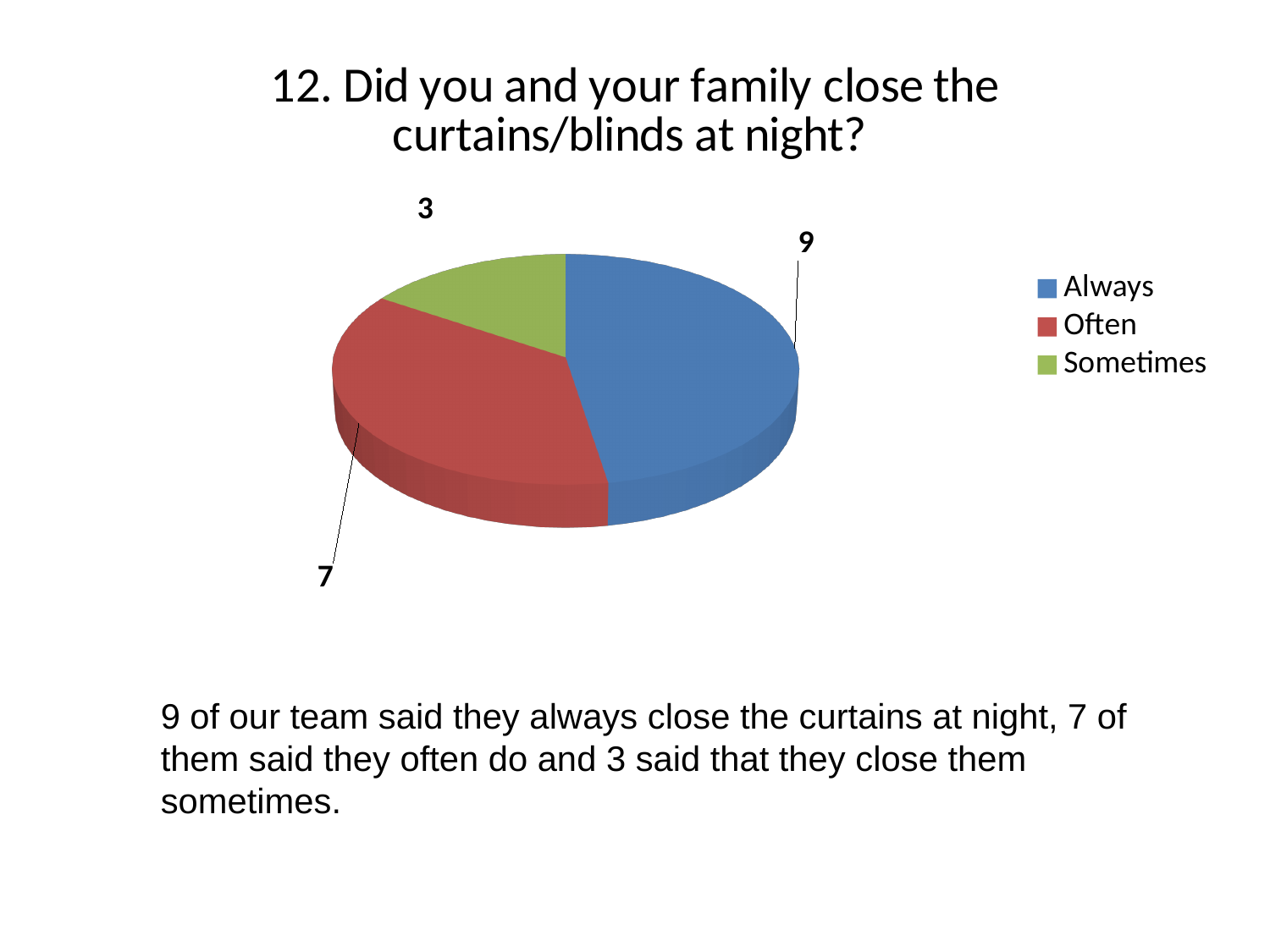
How many people answered "Always"? 9 How many people answered "Often"? 7 Which response has the largest slice of the pie? Always How many categories does the pie chart have? 3 What kind of chart is shown on the slide? pie chart What is the difference between the number who answered "Often" and the number who answered "Sometimes"? 4 What is the total number of responses shown in the pie chart? 19 How many people answered "Sometimes"? 3 What is the difference between the number who answered "Always" and the number who answered "Often"? 2 Which is larger, the "Often" slice or the "Sometimes" slice? Often What colour is the "Sometimes" slice? green Which response has the smallest slice of the pie? Sometimes